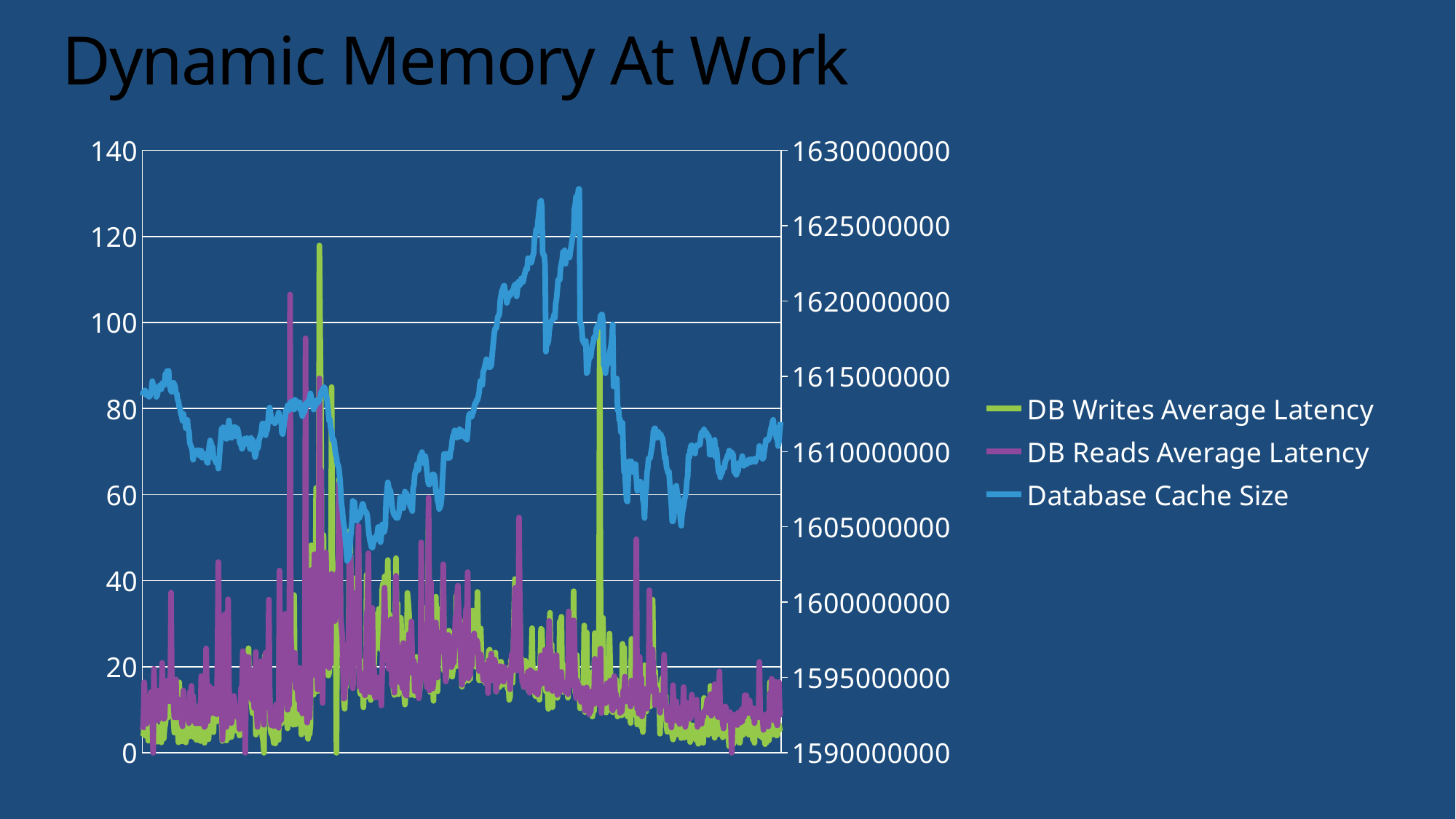
What are the three series listed in the legend? DB Writes Average Latency, DB Reads Average Latency, Database Cache Size What kind of chart is shown on the slide? line chart Is the highest peak of DB Reads Average Latency greater or less than 120 on the left axis? less Is the highest peak of DB Writes Average Latency greater or less than 100 on the left axis? greater Is the highest peak of Database Cache Size greater or less than 1625000000 on the right axis? greater What is the title of the slide containing the chart? Dynamic Memory At Work What is the maximum tick value shown on the left vertical axis? 140 Which latency series reaches the higher peak value: DB Writes Average Latency or DB Reads Average Latency? DB Writes Average Latency How many series does the legend list? 3 What is the maximum tick value shown on the right vertical axis? 1630000000